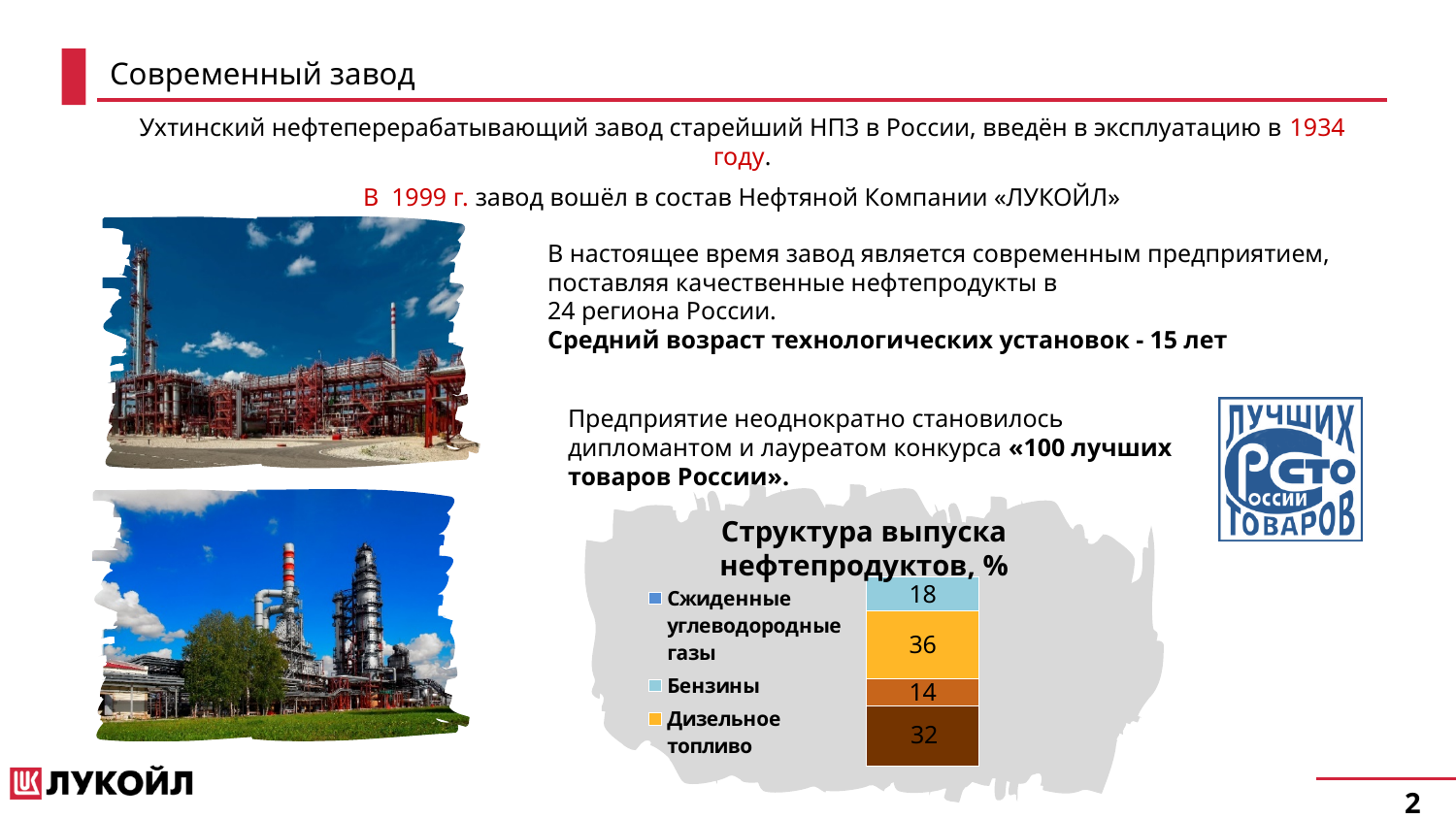
What is the title of the chart on the slide? Структура выпуска нефтепродуктов, % How many segments make up the stacked bar in the chart "Структура выпуска нефтепродуктов, %"? 4 What kind of chart is shown under the title "Структура выпуска нефтепродуктов, %"? Stacked bar chart What is the total of all segments in the stacked bar of the chart "Структура выпуска нефтепродуктов, %"? 100 In the chart "Структура выпуска нефтепродуктов, %", what is the difference between the values for Дизельное топливо and Бензины? 18 In the chart "Структура выпуска нефтепродуктов, %", what colour is the segment labelled 32? Brown In the chart "Структура выпуска нефтепродуктов, %", what value is shown for Бензины? 18 In the chart "Структура выпуска нефтепродуктов, %", which is larger: Дизельное топливо or Бензины? Дизельное топливо What is the smallest segment value in the stacked bar of the chart "Структура выпуска нефтепродуктов, %"? 14 What is the largest segment value in the stacked bar of the chart "Структура выпуска нефтепродуктов, %"? 36 In the chart "Структура выпуска нефтепродуктов, %", what value is shown for Дизельное топливо? 36